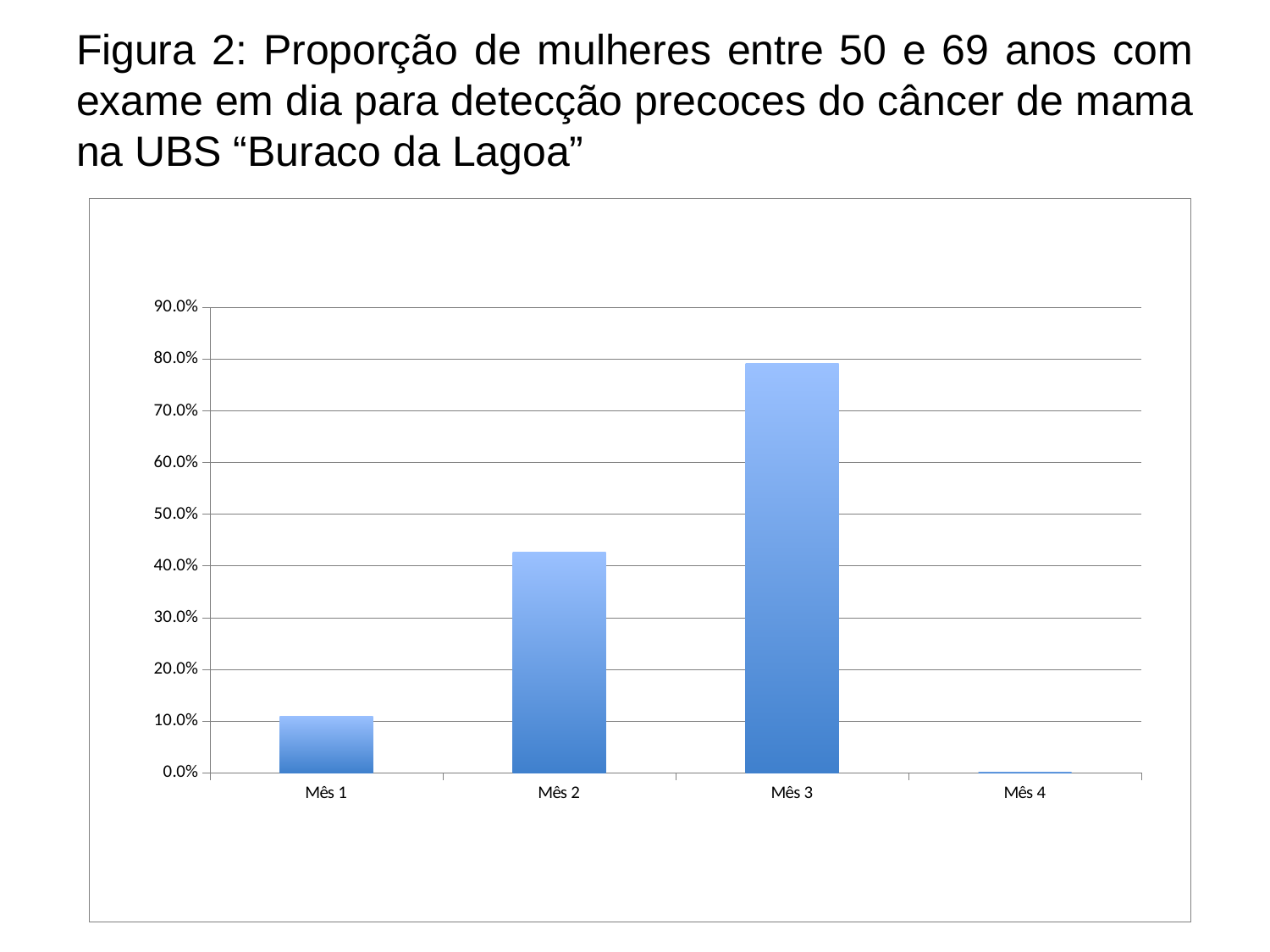
Which month has the highest value in the chart? Mês 3 Which is larger, the value for Mês 2 or the value for Mês 3? Mês 3 Is the value for Mês 3 greater or less than 70.0%? greater Is the value for Mês 1 greater or less than 20.0%? less Is the value for Mês 2 greater or less than 40.0%? greater Do the values rise or fall from Mês 1 to Mês 3? rise What is the highest value shown on the y axis of the chart? 90.0% Which is larger, the value for Mês 1 or the value for Mês 2? Mês 2 Which month has the lowest value in the chart? Mês 4 How many categories (months) are shown on the x axis of the chart? 4 What kind of chart is shown on the slide? bar chart